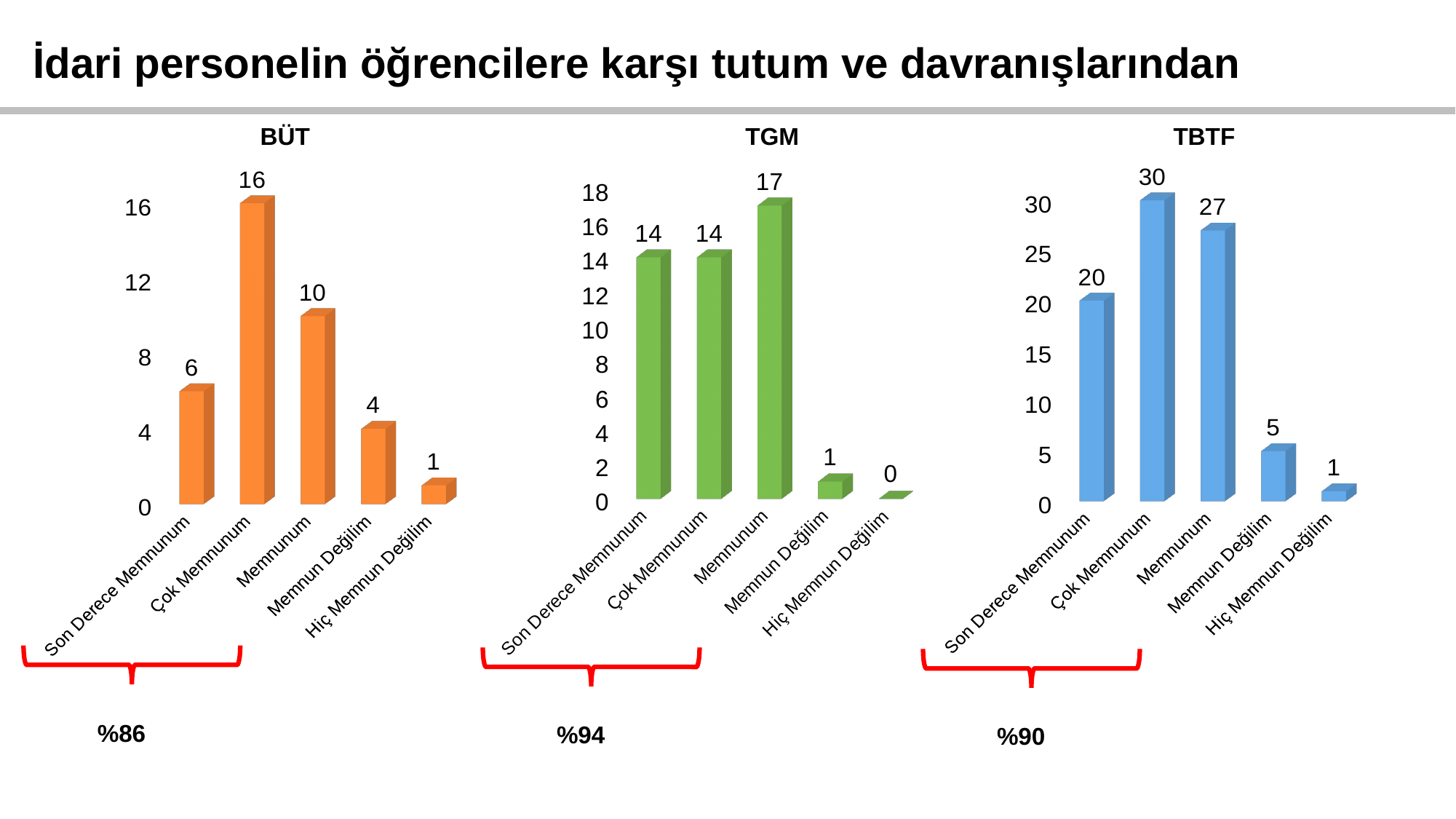
In the BÜT chart, what is the value for Çok Memnunum? 16 In the TBTF chart, which category has the highest value? Çok Memnunum In the TGM chart, which category has the lowest value? Hiç Memnun Değilim In the BÜT chart, what is the difference between the values for Çok Memnunum and Memnunum? 6 What kind of chart is the BÜT chart? Bar chart How many categories are shown on the x axis of the TGM chart? 5 In the TGM chart, what is the difference between the values for Memnunum and Çok Memnunum? 3 What colour are the bars in the TGM chart? Green In the TGM chart, what is the value for Memnunum? 17 In the TBTF chart, which is larger: the value for Memnunum or the value for Son Derece Memnunum? Memnunum In the TBTF chart, what is the value for Son Derece Memnunum? 20 In the TBTF chart, what is the value for Memnun Değilim? 5